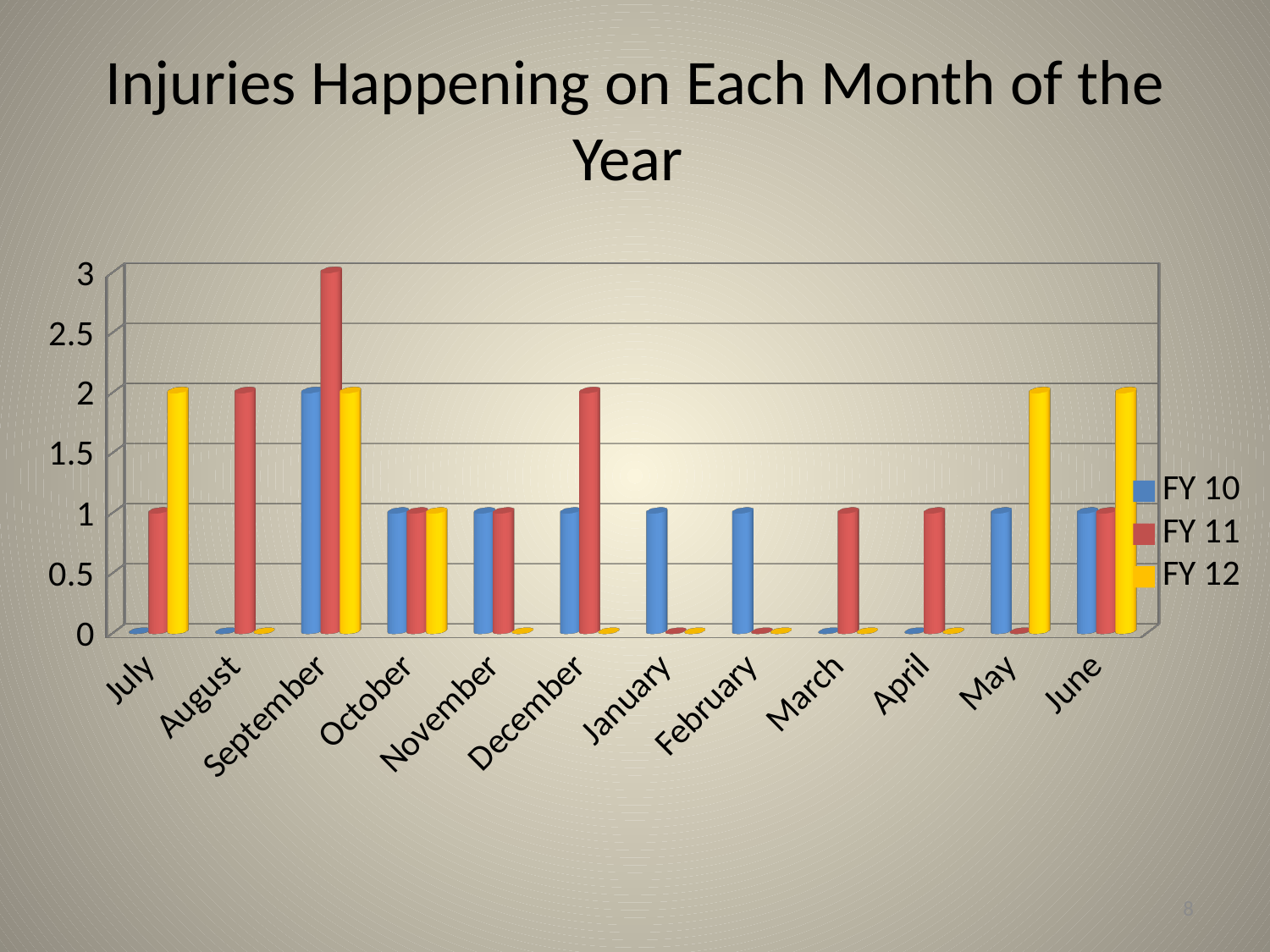
What is the difference between the FY 11 value and the FY 10 value for September? 1 Which month has the highest FY 11 value? September What is the FY 10 value for September? 2 What is the FY 12 value for July? 2 Is the FY 12 value for May greater or less than 1.5? greater What kind of chart is shown on the slide? Bar chart How many series does the legend list? 3 Which is larger for August: the FY 11 value or the FY 12 value? FY 11 How many months are shown on the x axis? 12 What is the FY 11 value for December? 2 What is the FY 11 value for September? 3 What is the title of the chart? Injuries Happening on Each Month of the Year